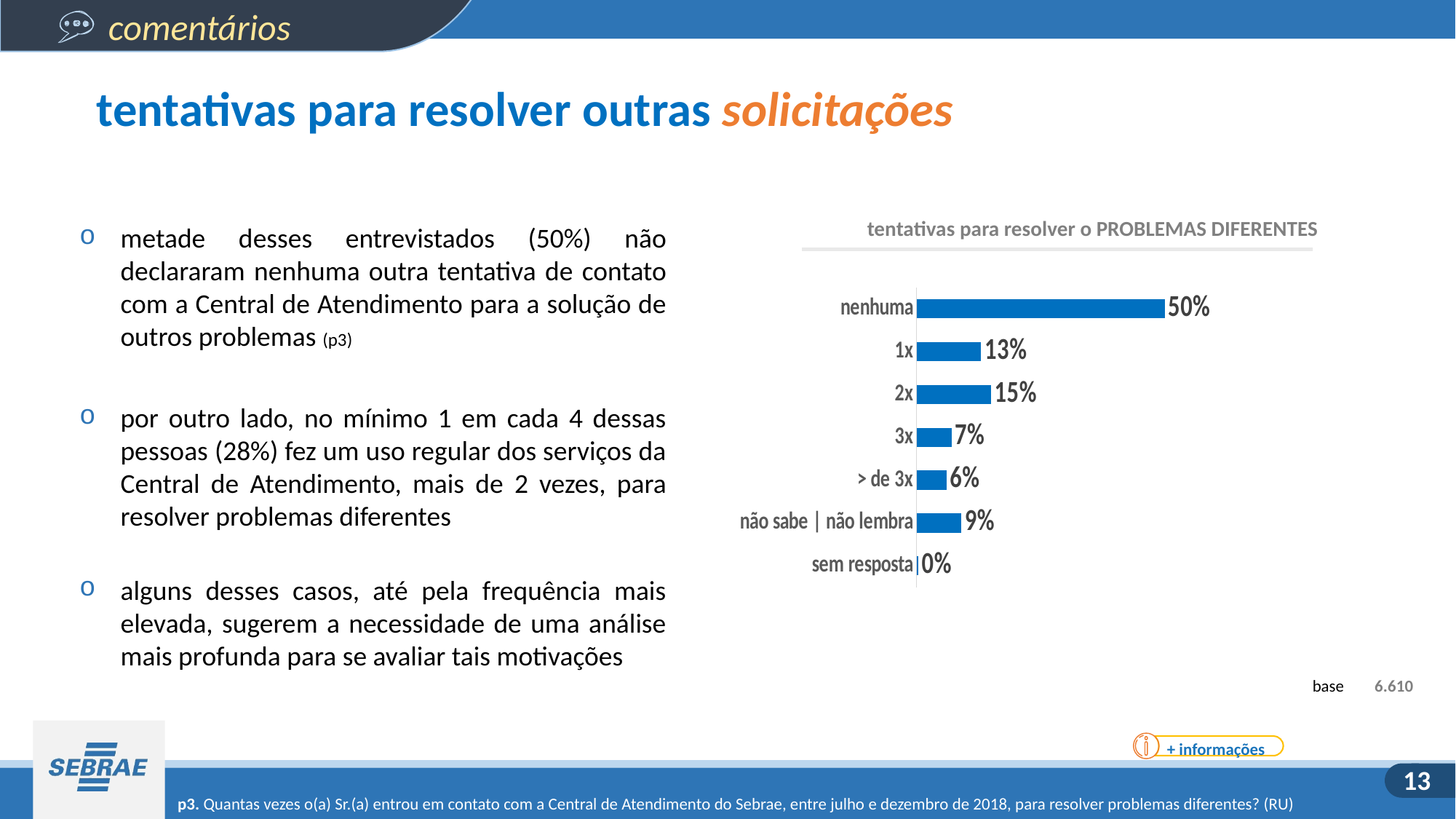
Which category has the lowest value? sem resposta What is the difference between the values for "nenhuma" and "2x"? 35% Which category has the highest value? nenhuma What is the title of the chart? tentativas para resolver o PROBLEMAS DIFERENTES What is the value for "> de 3x"? 6% Which is larger, the value for "1x" or the value for "2x"? 2x What is the value for "nenhuma"? 50% What kind of chart is shown on the slide? bar chart What is the value for "2x"? 15% What is the difference between the values for "1x" and "3x"? 6% How many categories are shown in the chart? 7 What is the value for "não sabe | não lembra"? 9%